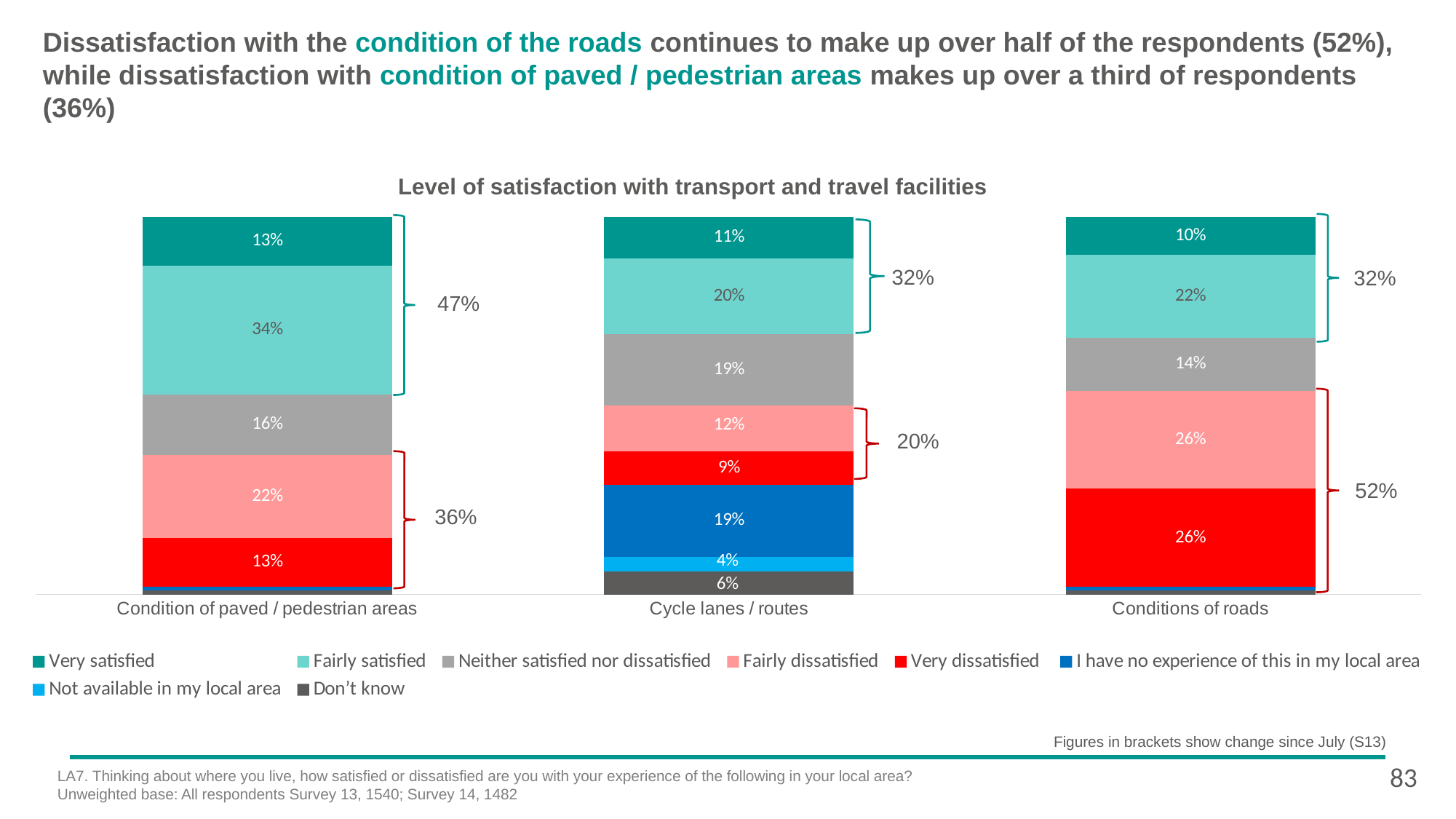
Which category has the lowest 'Very dissatisfied' value? Cycle lanes / routes How many categories are shown along the x axis? 3 What percentage of respondents are very dissatisfied with the conditions of roads? 26% What is the difference between the 'Fairly dissatisfied' values for conditions of roads and cycle lanes / routes? 14% What kind of chart is shown on the slide? Stacked bar chart What is the chart's title? Level of satisfaction with transport and travel facilities What percentage of respondents answered 'Don't know' for cycle lanes / routes? 6% Which category has the highest 'Very satisfied' value? Condition of paved / pedestrian areas What percentage of respondents say they have no experience of cycle lanes / routes in their local area? 19% How many series does the legend list? 8 Which is larger: the 'Neither satisfied nor dissatisfied' value for cycle lanes / routes or for conditions of roads? Cycle lanes / routes What percentage of respondents are fairly satisfied with the condition of paved / pedestrian areas? 34%